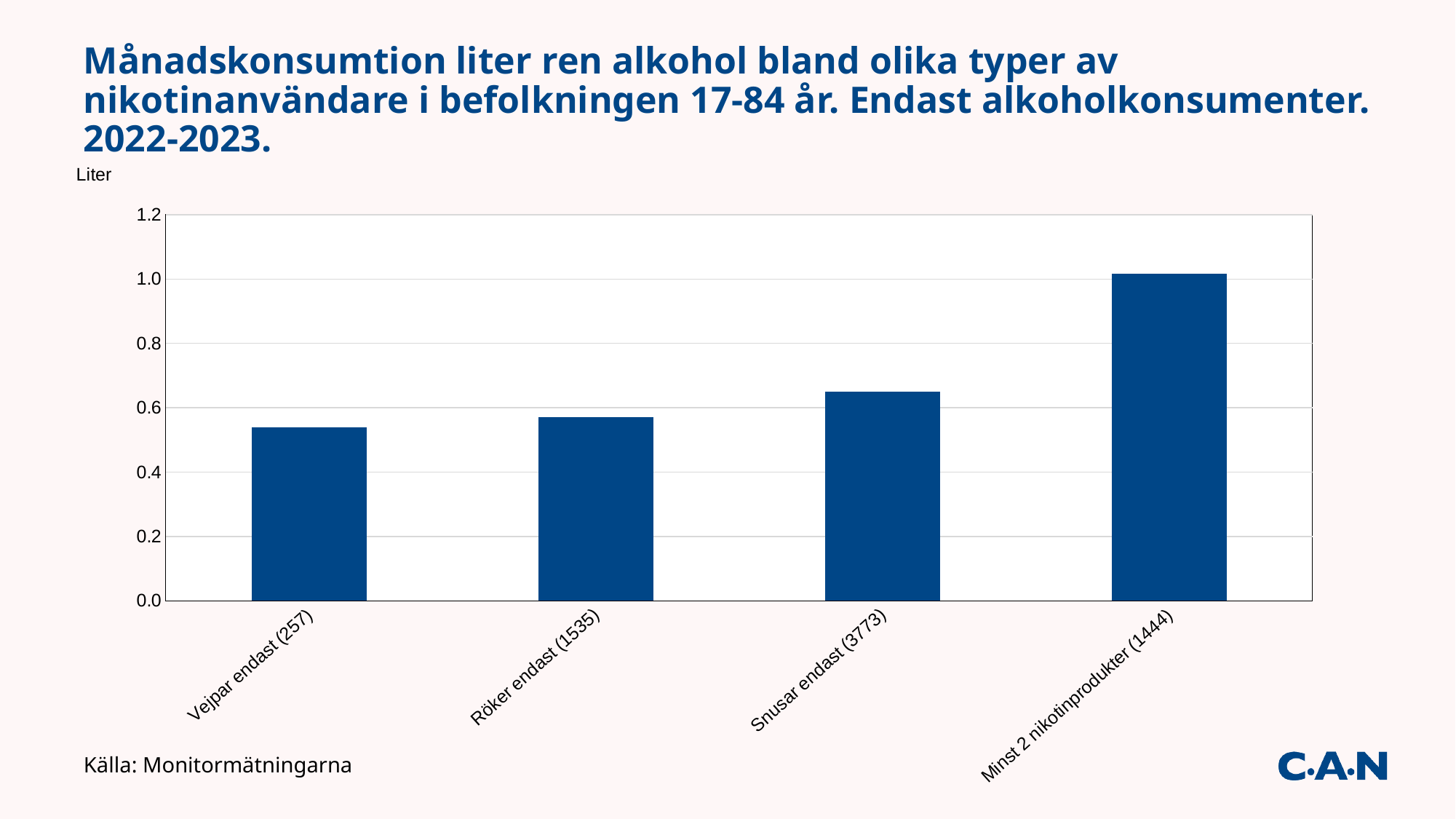
What kind of chart is shown on the slide? bar chart What source is cited below the chart? Monitormätningarna Is the value for Minst 2 nikotinprodukter (1444) greater or less than 0.8? greater Is the value for Röker endast (1535) greater or less than 0.8? less Is the value for Vejpar endast (257) greater or less than 0.6? less How many categories are plotted on the x axis? 4 Which category has the lowest monthly consumption? Vejpar endast (257) Which category has the highest monthly consumption? Minst 2 nikotinprodukter (1444) Which is larger, the value for Snusar endast (3773) or Röker endast (1535)? Snusar endast (3773) What unit is shown on the y axis label? Liter Do the values rise or fall from left to right along the x axis? rise